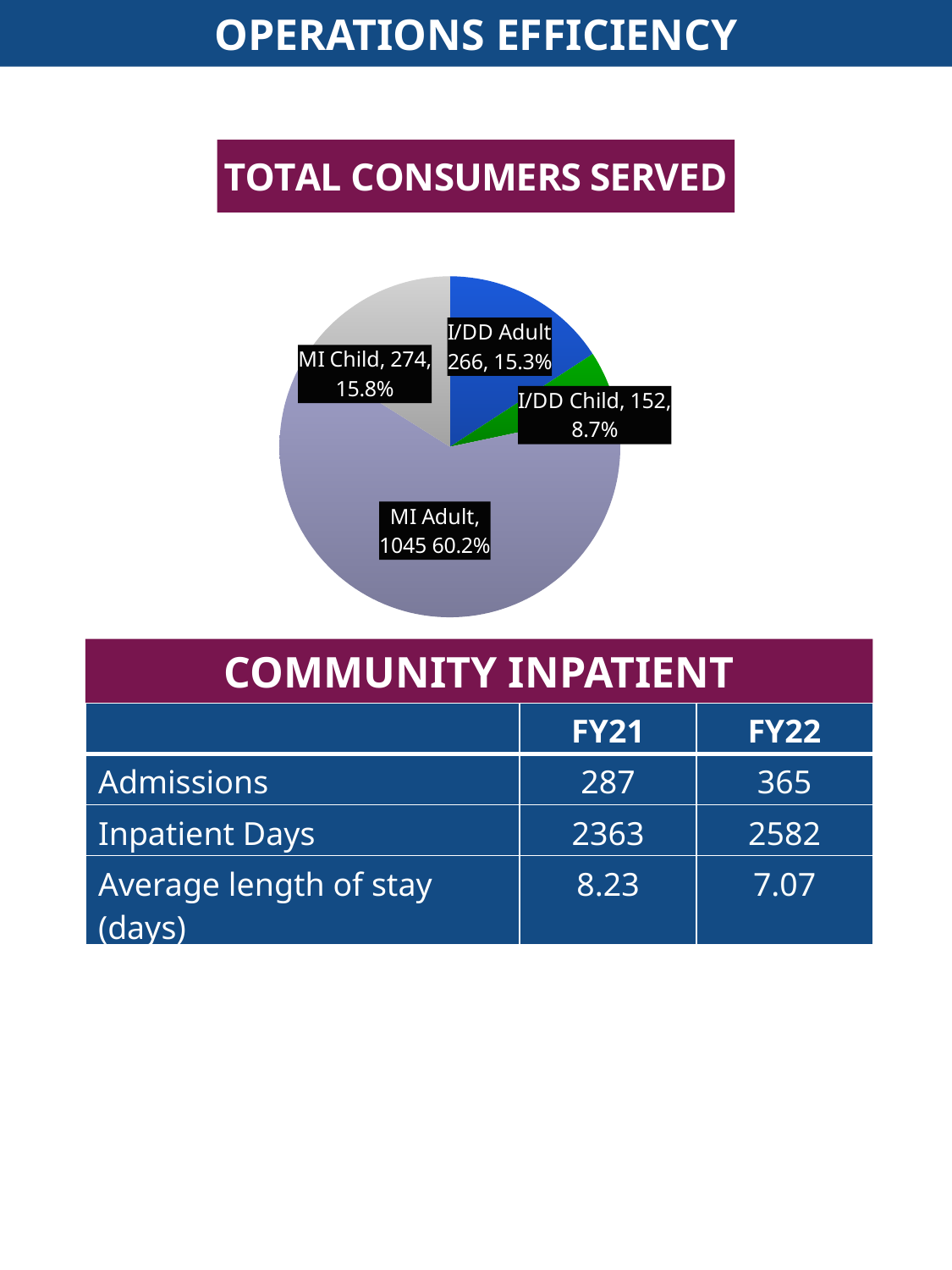
What share of the TOTAL CONSUMERS SERVED pie does MI Adult represent? 60.2% Which category has the largest slice in the TOTAL CONSUMERS SERVED pie chart? MI Adult In the TOTAL CONSUMERS SERVED pie chart, which is larger, I/DD Adult or I/DD Child? I/DD Adult How many slices does the TOTAL CONSUMERS SERVED pie chart have? 4 What is the value for MI Child in the TOTAL CONSUMERS SERVED pie chart? 274 Which category has the smallest slice in the TOTAL CONSUMERS SERVED pie chart? I/DD Child What is the value for I/DD Adult in the TOTAL CONSUMERS SERVED pie chart? 266 In the TOTAL CONSUMERS SERVED pie chart, what is the difference between the MI Adult value and the MI Child value? 771 What is the value for I/DD Child in the TOTAL CONSUMERS SERVED pie chart? 152 What kind of chart is shown under the heading TOTAL CONSUMERS SERVED? Pie chart What share of the TOTAL CONSUMERS SERVED pie does I/DD Child represent? 8.7% What is the value for MI Adult in the TOTAL CONSUMERS SERVED pie chart? 1045